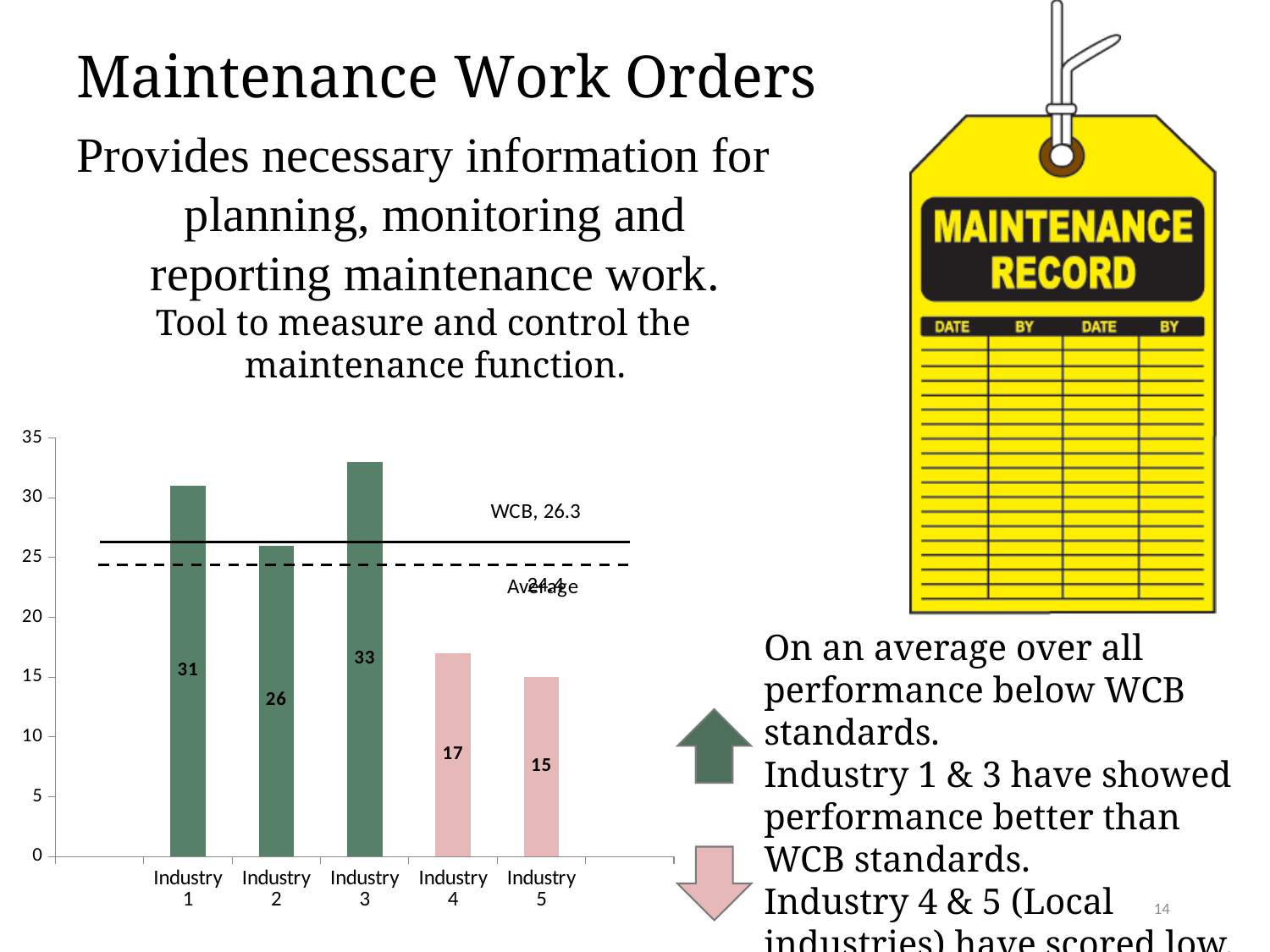
Which industry has the highest value? Industry 3 What is the value for Industry 5? 15 Which is larger, the value for Industry 1 or the value for Industry 2? Industry 1 How many industries are shown on the x axis? 5 What is the value for Industry 4? 17 What is the difference between the values for Industry 3 and Industry 2? 7 What kind of chart is shown on the slide? bar chart Is the value for Industry 4 greater or less than 20? less Which industry has the lowest value? Industry 5 What value is labelled for the WCB line on the chart? 26.3 What is the difference between the Industry 1 value and the Industry 5 value? 16 What is the value for Industry 1? 31